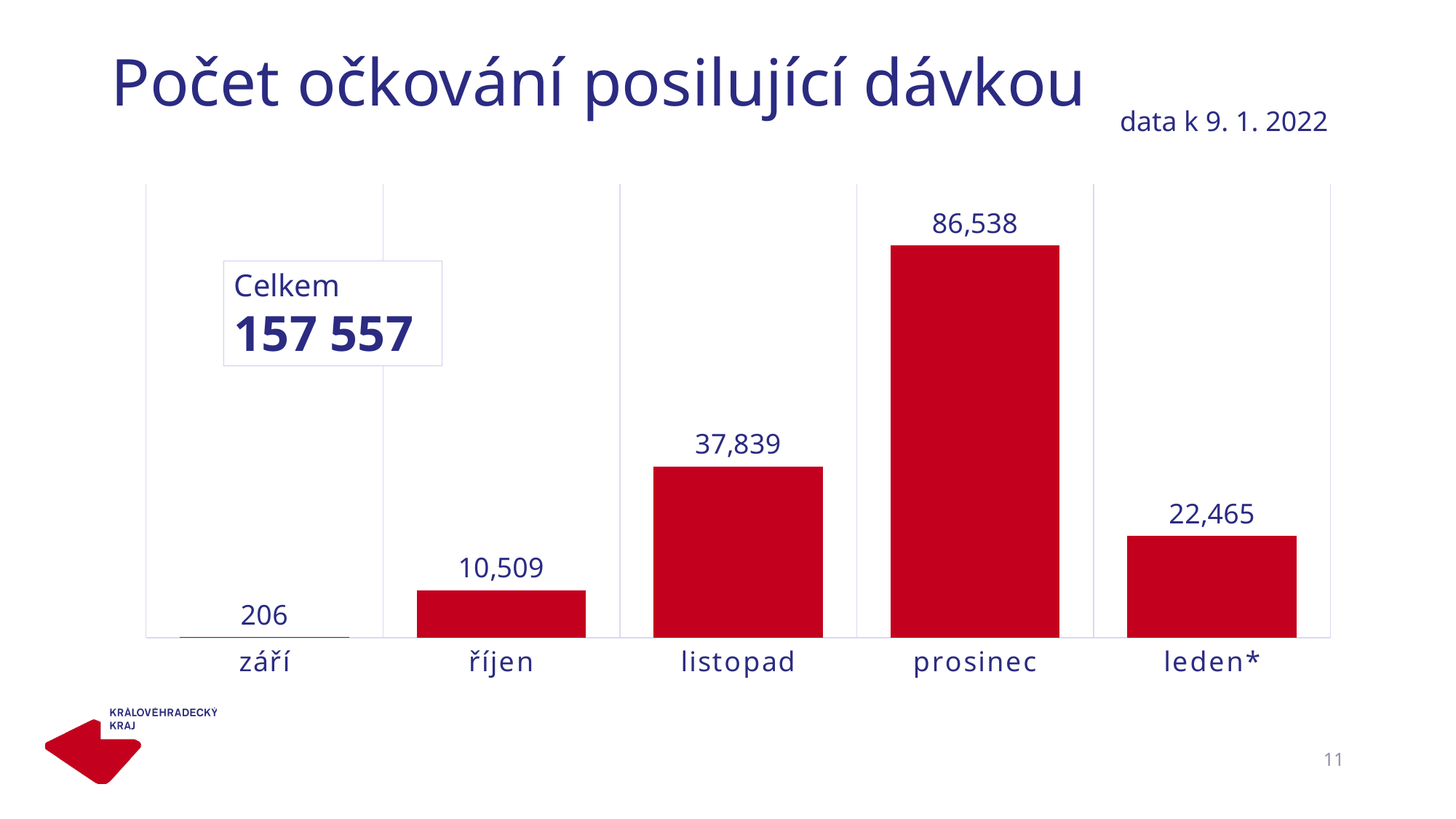
What is the value for září? 206 What kind of chart is shown on the slide? bar chart Which is larger, the value for listopad or the value for leden*? listopad Do the values rise or fall from září to prosinec? rise What is the difference between the values for leden* and říjen? 11,956 What is the value for prosinec? 86,538 Which month has the highest value? prosinec What is the value for leden*? 22,465 Which month has the lowest value? září What is the difference between the values for prosinec and listopad? 48,699 What is the value for říjen? 10,509 How many months are shown on the x axis? 5